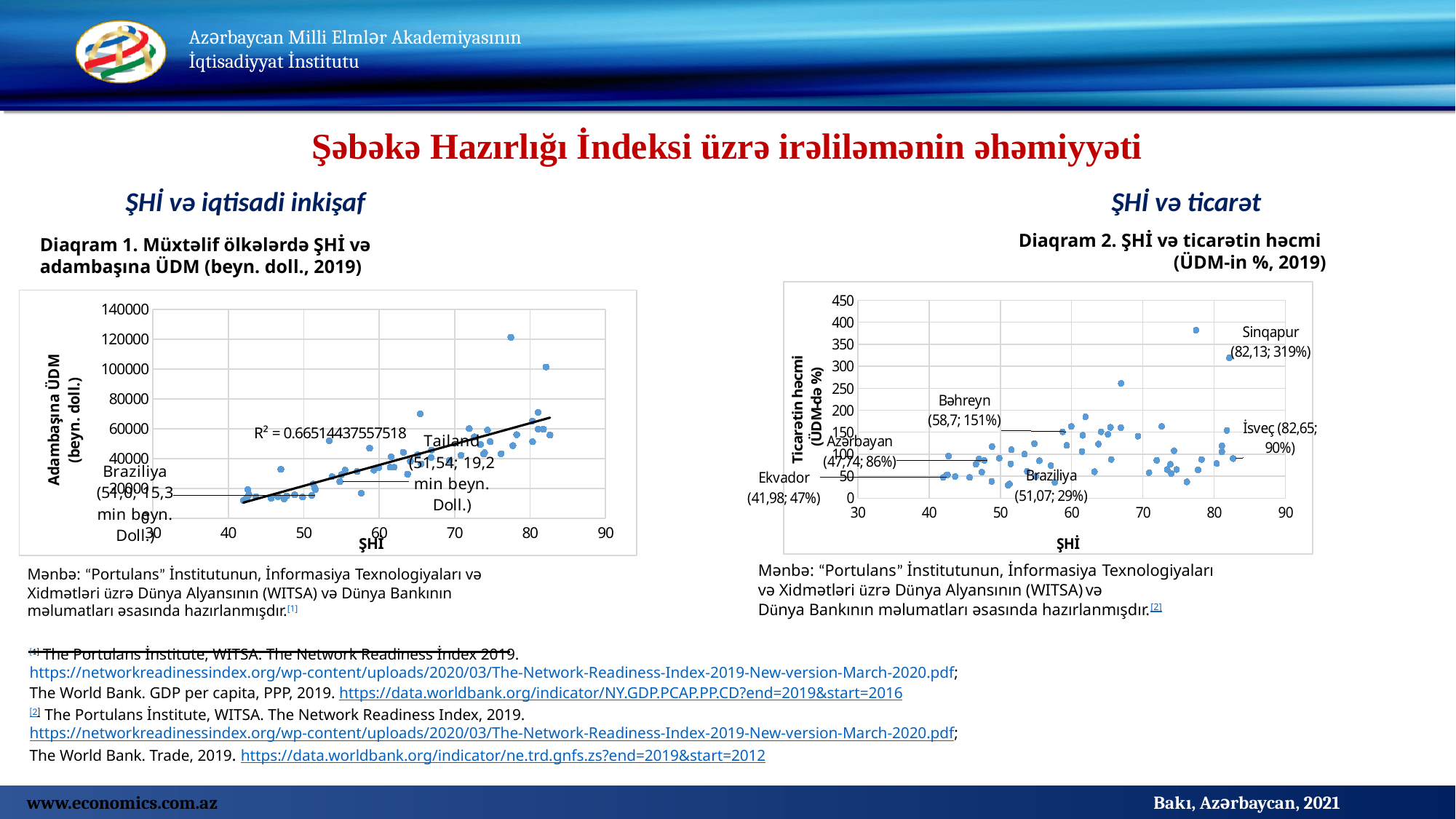
What kind of chart is Diaqram 1 (ŞHİ və adambaşına ÜDM)? Scatter chart In Diaqram 1, do the values of adambaşına ÜDM generally rise or fall as ŞHİ increases along the x axis? Rise In Diaqram 2, which has the larger labelled trade volume, Bəhreyn or İsveç? Bəhreyn In Diaqram 1, is the highest plotted adambaşına ÜDM value greater or less than 100000? greater In Diaqram 2, what is the difference between the labelled trade volumes of Bəhreyn (151%) and Azərbaycan (86%)? 65 percentage points In Diaqram 1, what R² value is printed next to the trend line? R² = 0.66514437557518 In Diaqram 2, what trade volume (ÜDM-in %) is labelled for Sinqapur? 319% In Diaqram 2, what is the label of the y axis? Ticarətin həcmi (ÜDM-də %) In Diaqram 2, what trade volume is labelled for Ekvador? 47% In Diaqram 1, what ŞHİ value is labelled for Tailand? 51,54 In Diaqram 1, what adambaşına ÜDM value is labelled for Braziliya? 15,3 min beyn. Doll. In Diaqram 2, what ŞHİ value is labelled for Azərbaycan? 47,74